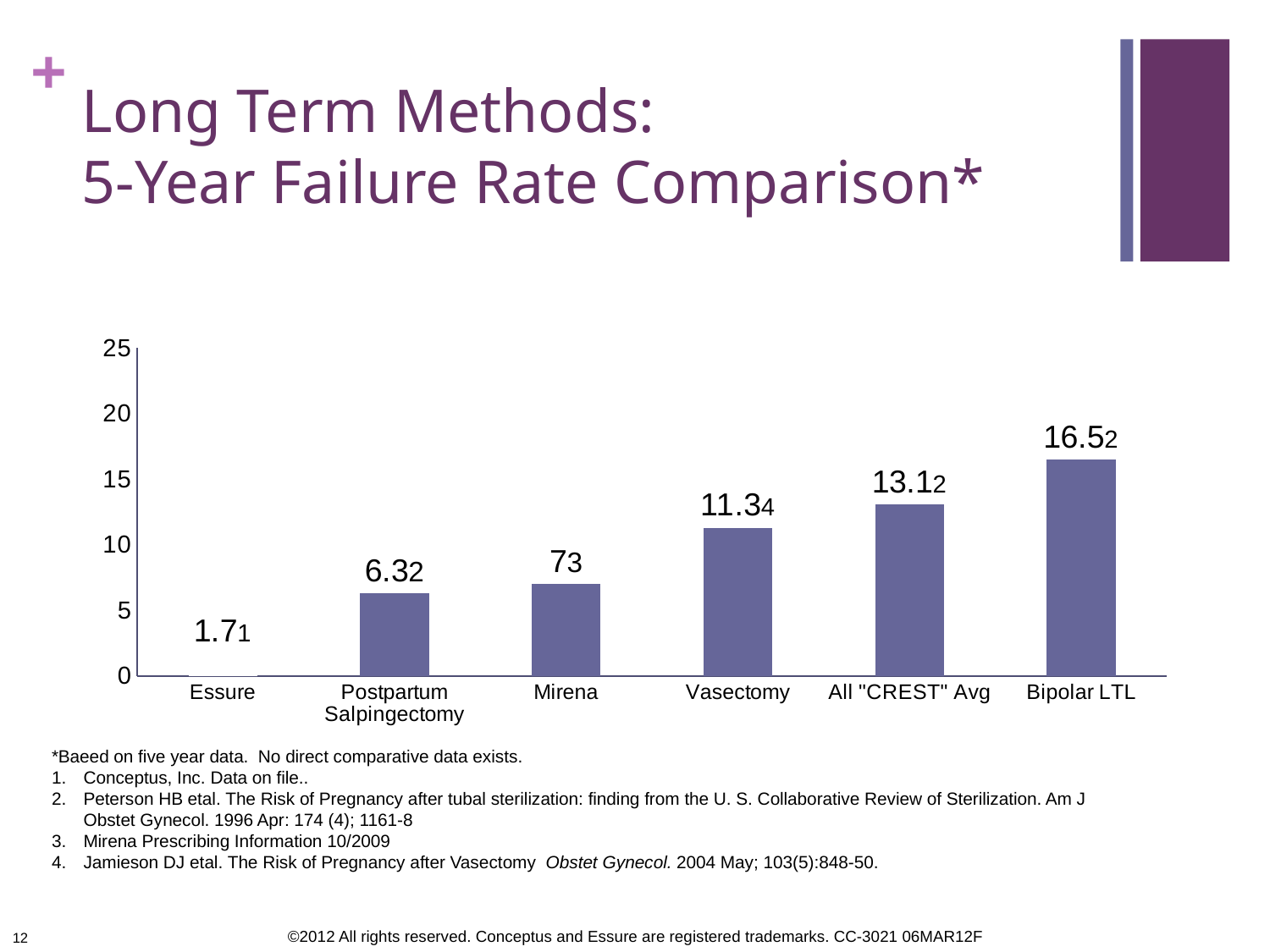
Which is larger, the value for Vasectomy or the value for Mirena? Vasectomy What is the difference between the values for Bipolar LTL and All "CREST" Avg? 3.4 What value is labelled for Postpartum Salpingectomy? 6.3 What value is labelled for Mirena? 7 How many methods are shown on the x axis? 6 Is the value for All "CREST" Avg greater or less than 10? greater What value is labelled for Bipolar LTL? 16.5 Which method has the lowest value on the chart? Essure What kind of chart is shown on the slide? Bar chart What is the 5-year failure rate shown for Vasectomy? 11.3 Which method has the highest value on the chart? Bipolar LTL Do the values rise or fall moving from left to right along the x axis? Rise